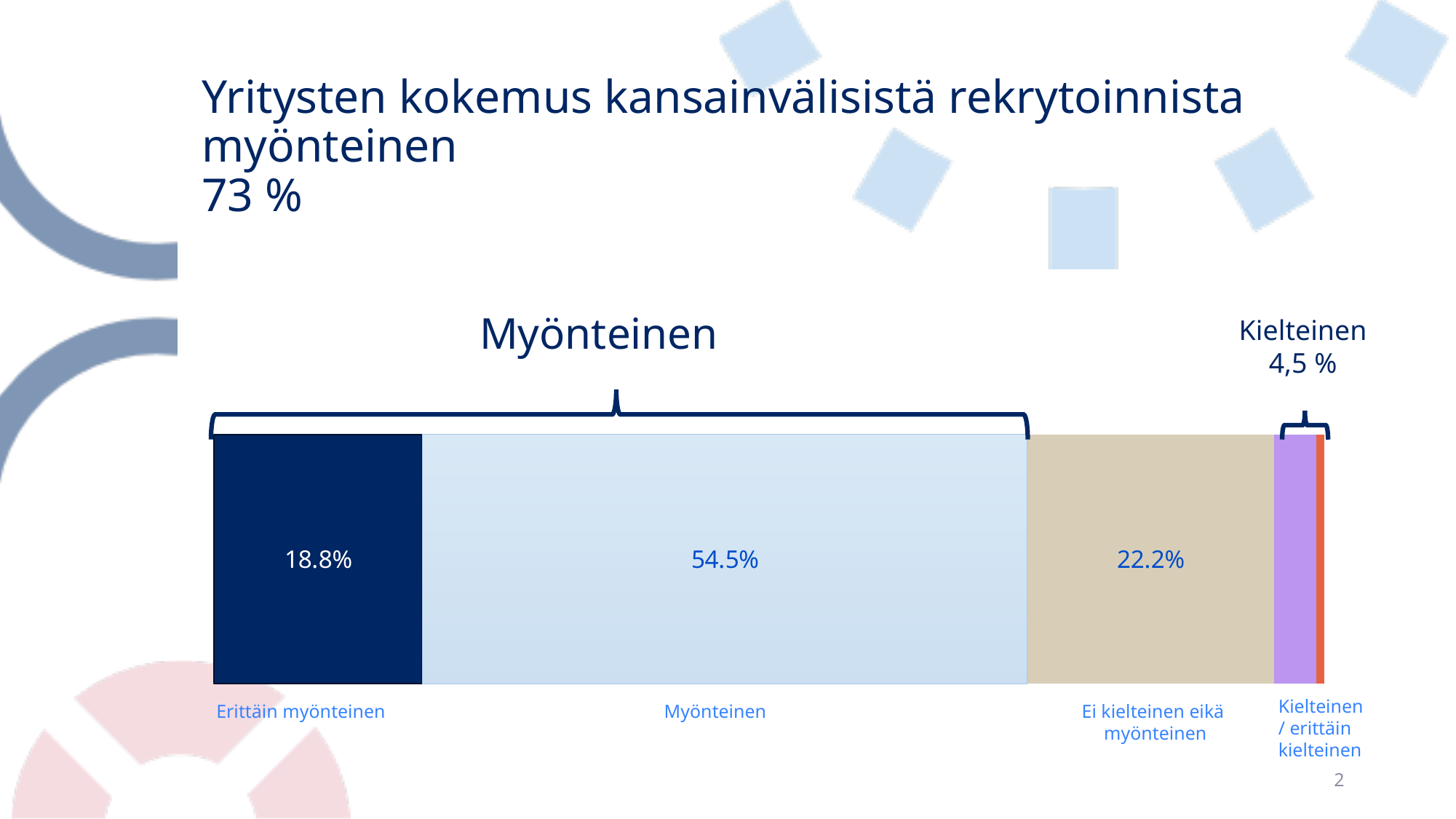
Which labelled group has the smallest share? Kielteinen / erittäin kielteinen What percentage is shown for the Erittäin myönteinen segment? 18.8% What percentage is given for the Kielteinen group above the bracket on the right? 4,5 % Which is larger, the Ei kielteinen eikä myönteinen segment or the Erittäin myönteinen segment? Ei kielteinen eikä myönteinen Which segment of the bar has the largest share? Myönteinen What colour is the Erittäin myönteinen segment of the bar? Dark blue What is the difference in percentage points between the Myönteinen segment (54.5%) and the Erittäin myönteinen segment (18.8%)? 35.7 percentage points According to the slide, what combined share of companies had a positive (Myönteinen) experience? 73 % What percentage is shown for the Ei kielteinen eikä myönteinen segment? 22.2% What percentage is shown for the Myönteinen segment of the bar? 54.5% What kind of chart is shown on the slide? Stacked bar chart How many labelled categories are shown under the bar? 4